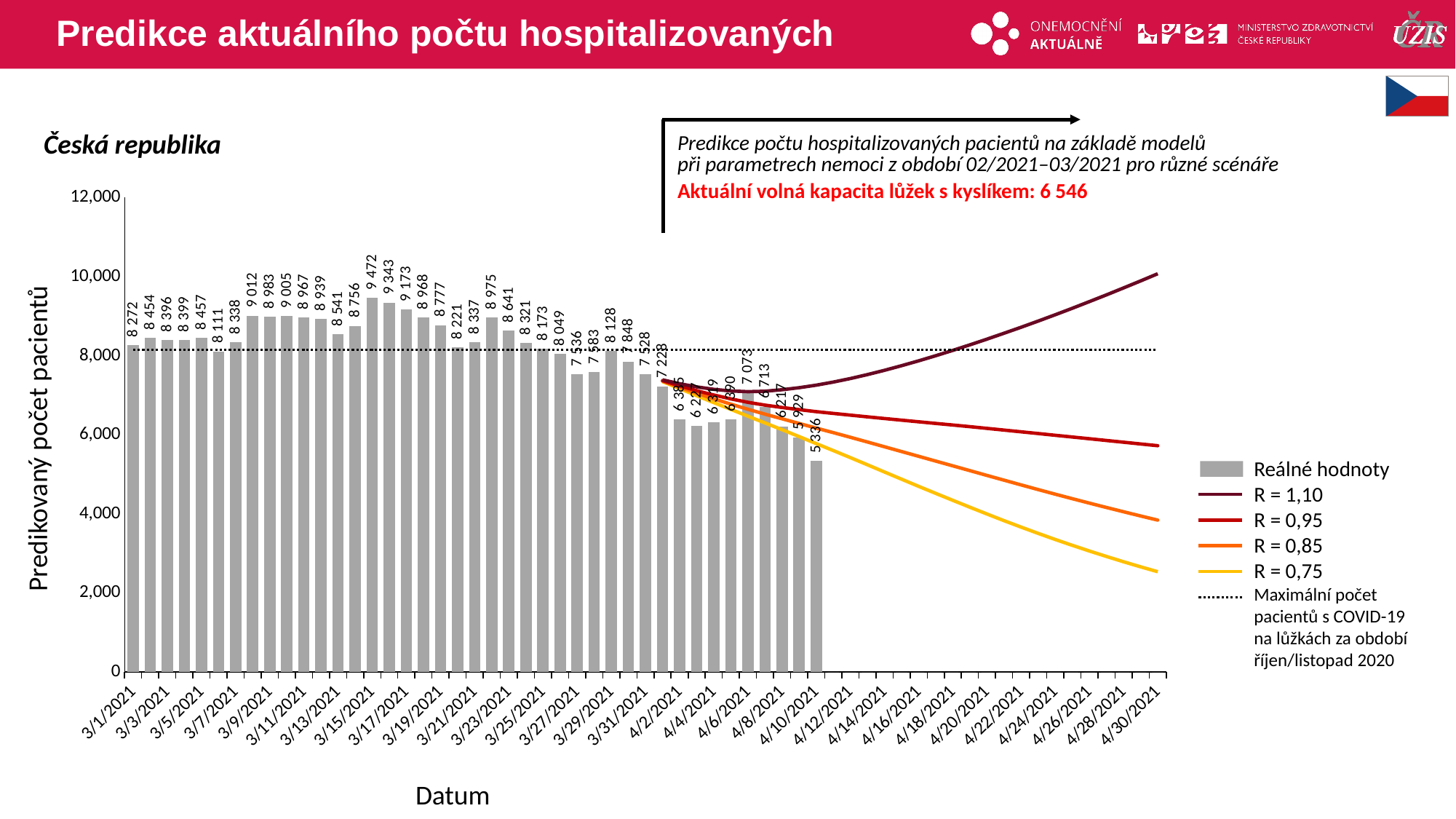
Does the R = 0,75 line rise or fall from 4/10/2021 to 4/30/2021? fall What is the current free capacity of beds with oxygen stated on the slide? 6 546 What is the difference between the bar values for 3/15/2021 and 3/1/2021? 1 200 What is the value of the bar for 3/1/2021? 8 272 Is the value of the R = 1,10 line on 4/30/2021 greater or less than 8,000? greater What is the title of the chart on the slide? Predikce aktuálního počtu hospitalizovaných Which date has the lowest bar (Reálné hodnoty)? 4/10/2021 What is the value of the bar for 3/15/2021? 9 472 How many series does the legend list? 6 Which is larger, the bar for 4/6/2021 or the bar for 4/10/2021? 4/6/2021 What type of chart is shown on the slide? Combined bar and line chart Which date has the highest bar (Reálné hodnoty)? 3/15/2021